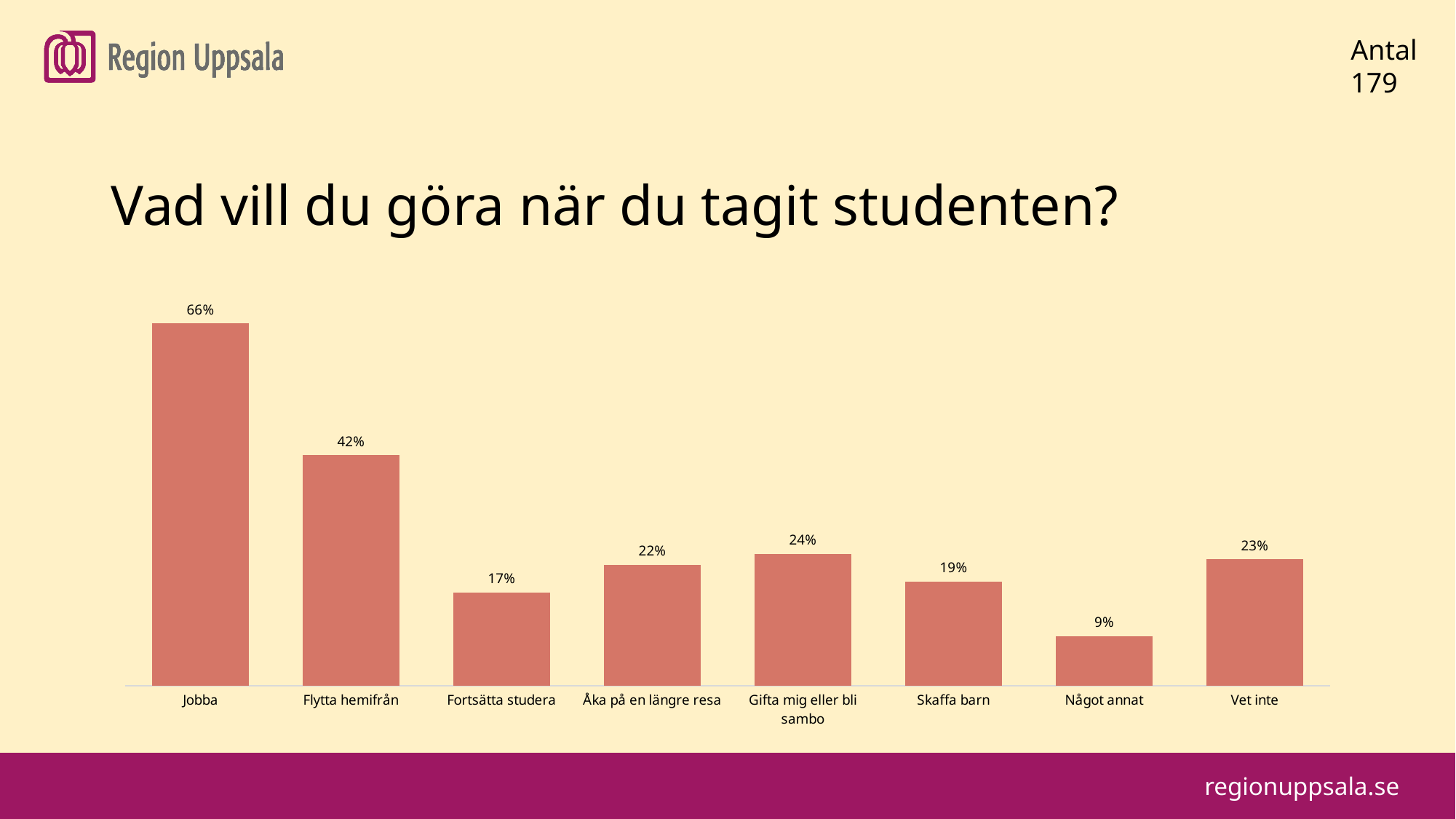
Which is larger, the value for Fortsätta studera or the value for Åka på en längre resa? Åka på en längre resa What is the difference between the values for Skaffa barn and Något annat? 10% What is the value for Gifta mig eller bli sambo? 24% What is the value for Flytta hemifrån? 42% How many categories are shown in the chart? 8 Which category has the lowest value? Något annat What kind of chart is shown on the slide? Bar chart What is the value for Jobba? 66% What is the value for Vet inte? 23% Which category has the highest value? Jobba What is the title of the slide? Vad vill du göra när du tagit studenten? What is the difference between the values for Jobba and Flytta hemifrån? 24%